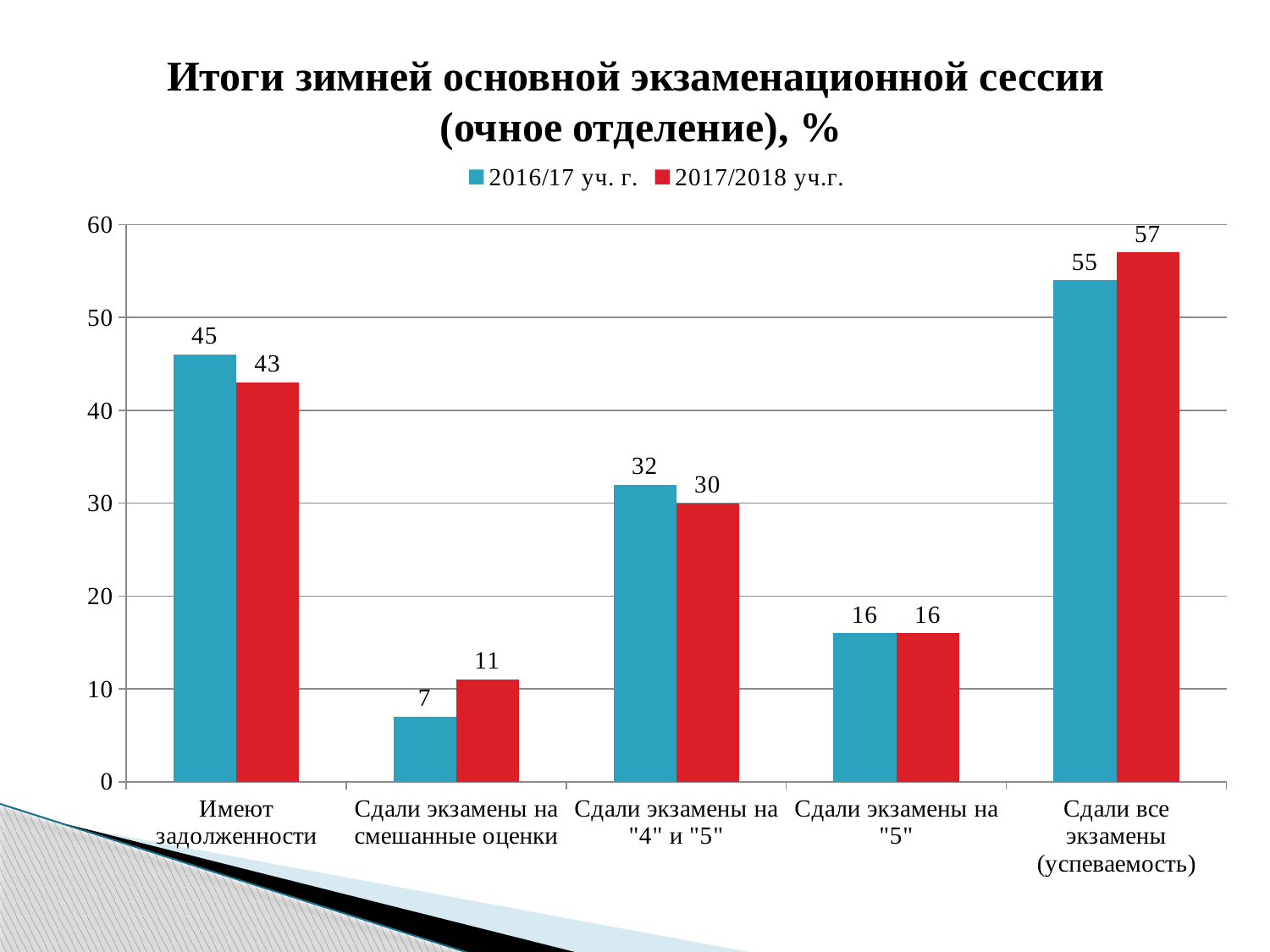
How many categories are shown on the x axis? 5 What kind of chart is shown on the slide? bar chart What is the value for "Сдали экзамены на смешанные оценки" in the 2017/2018 уч.г. series? 11 How many series does the legend list? 2 Is the 2016/17 уч. г. value for "Сдали экзамены на "4" и "5"" greater or less than 30? greater Which category has the highest value in the 2016/17 уч. г. series? Сдали все экзамены (успеваемость) What is the value for "Имеют задолженности" in the 2016/17 уч. г. series? 45 Which category has the lowest value in the 2017/2018 уч.г. series? Сдали экзамены на смешанные оценки What colour are the bars for the 2017/2018 уч.г. series? red What is the value for "Сдали все экзамены (успеваемость)" in the 2017/2018 уч.г. series? 57 Which series has the larger value for "Имеют задолженности", 2016/17 уч. г. or 2017/2018 уч.г.? 2016/17 уч. г. What is the difference between the 2016/17 уч. г. and 2017/2018 уч.г. values for "Сдали экзамены на "4" и "5""? 2